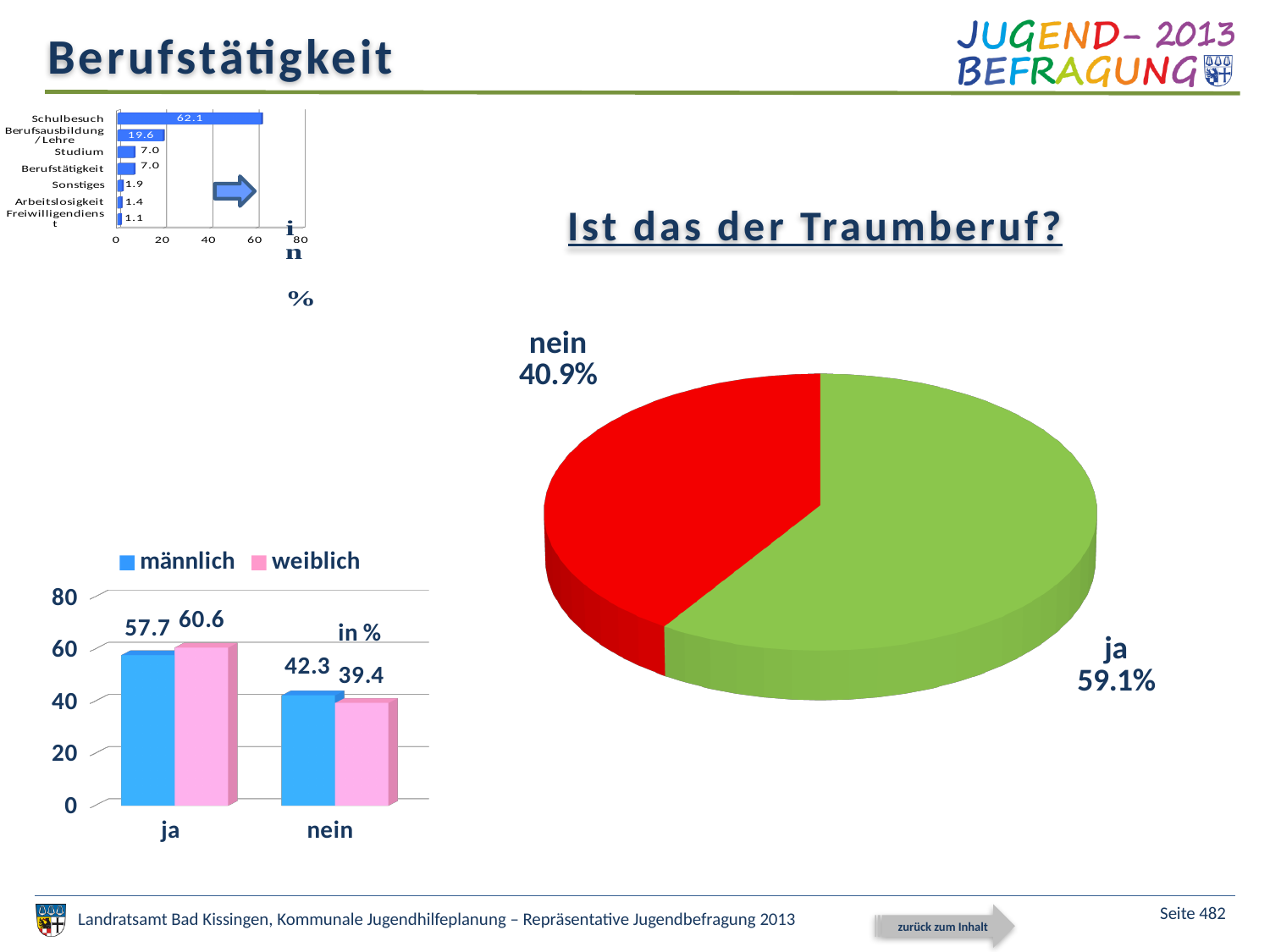
In the pie chart 'Ist das der Traumberuf?', what share is labelled 'ja'? 59.1% In the top-left bar chart, what is the value for 'Berufsausbildung / Lehre'? 19.6 In the bottom-left bar chart, how many series does the legend list? 2 In the pie chart 'Ist das der Traumberuf?', what share is labelled 'nein'? 40.9% In the pie chart 'Ist das der Traumberuf?', how many slices are there? 2 What kind of chart is the bottom-left chart? bar chart In the top-left bar chart, which category has the lowest value? Freiwilligendienst In the bottom-left bar chart, what is the difference between 'männlich' and 'weiblich' in the 'nein' category? 2.9 In the pie chart 'Ist das der Traumberuf?', which slice is larger, 'ja' or 'nein'? ja In the bottom-left bar chart, what is the value for 'weiblich' in the 'ja' category? 60.6 In the top-left bar chart, how many categories are shown? 7 In the top-left bar chart, what is the value for 'Schulbesuch'? 62.1